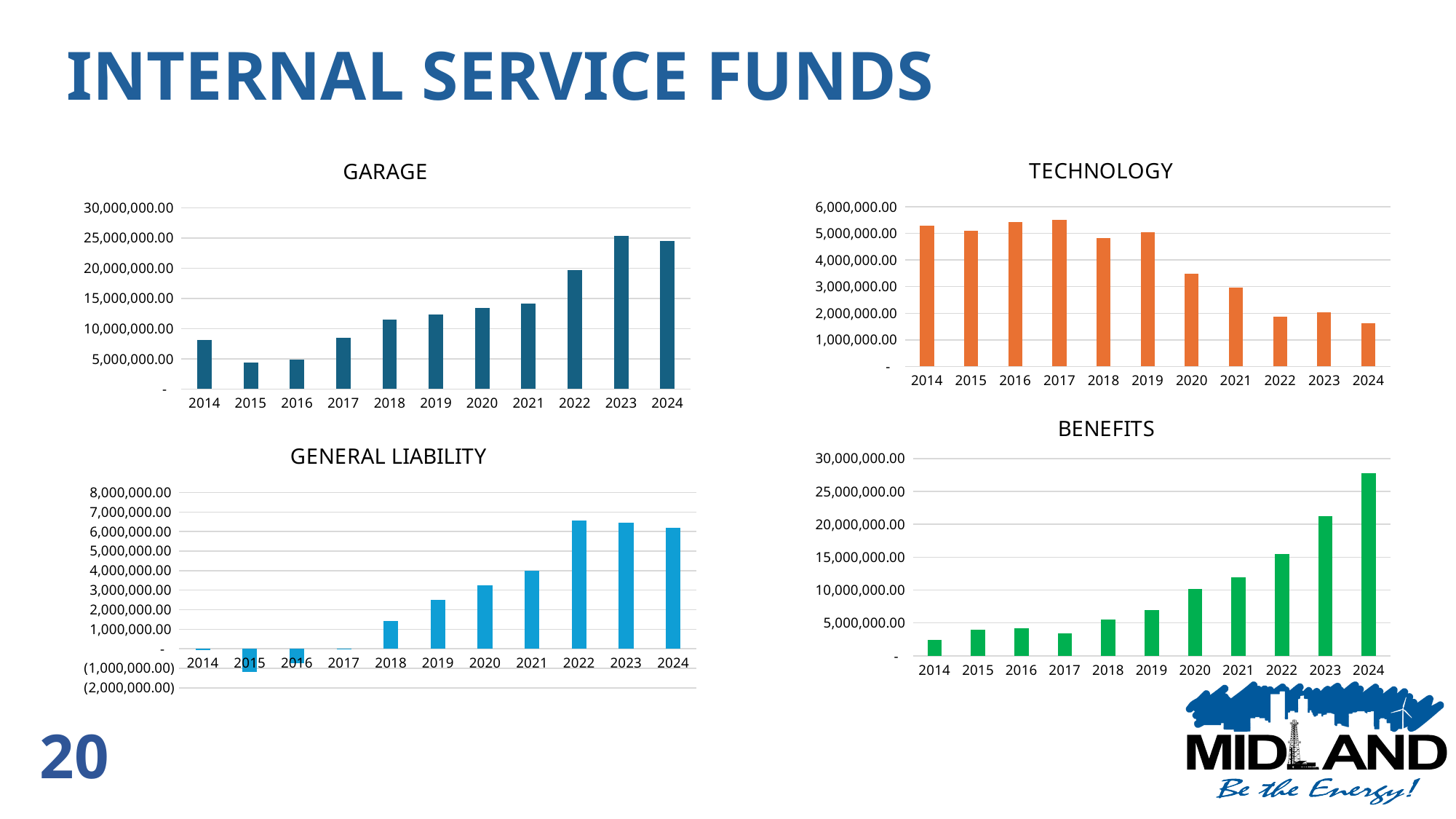
In the BENEFITS chart, which year has the highest value? 2024 In the TECHNOLOGY chart, which is larger, the value for 2016 or the value for 2022? 2016 In the GARAGE chart, is the value for 2014 greater or less than 5,000,000.00? greater In the GENERAL LIABILITY chart, is the value for 2018 greater or less than 1,000,000.00? greater In the TECHNOLOGY chart, is the value for 2020 greater or less than 3,000,000.00? greater In the BENEFITS chart, which year has the lowest value? 2014 How many years are shown on the x axis of the GARAGE chart? 11 In the GENERAL LIABILITY chart, which year has the lowest value? 2015 In the TECHNOLOGY chart, do the values generally rise or fall from 2014 to 2024? fall What kind of chart is the BENEFITS chart? bar chart